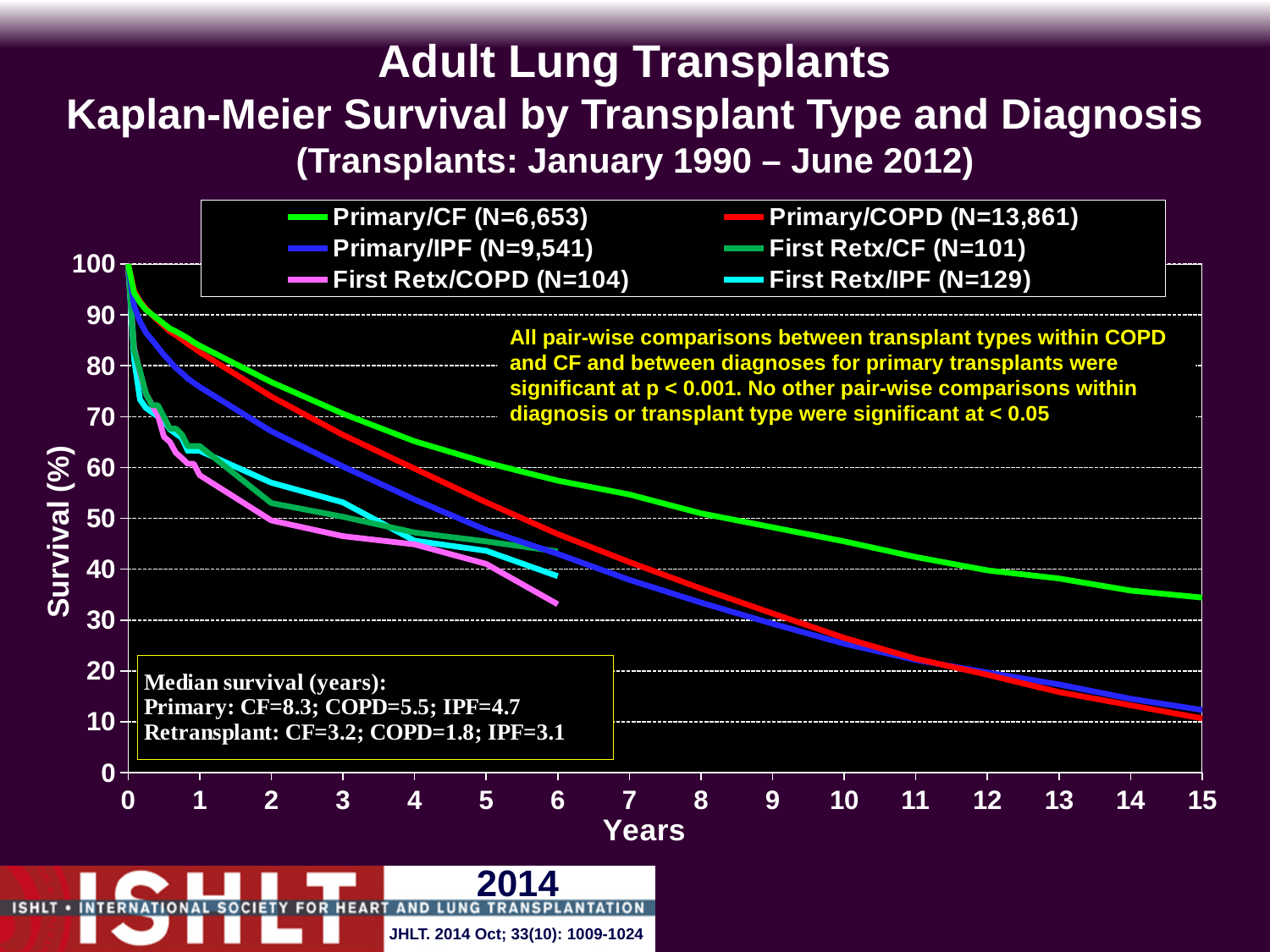
What is the difference in median survival (years) between primary CF and primary COPD transplants? 2.8 According to the text box, what is the median survival in years for COPD retransplants? 1.8 What is the label of the x axis? Years Which series has the highest survival at 10 years? Primary/CF What kind of chart is shown on the slide? line chart According to the text box, what is the median survival in years for primary CF transplants? 8.3 Is the survival for Primary/COPD at 15 years greater or less than 20? less Do the survival curves rise or fall as years increase? fall Which group has the lowest median survival listed in the text box? Retransplant COPD Is the survival for Primary/CF at 15 years greater or less than 30? greater How many series does the legend list? 6 What is the N shown in the legend for Primary/COPD? N=13,861